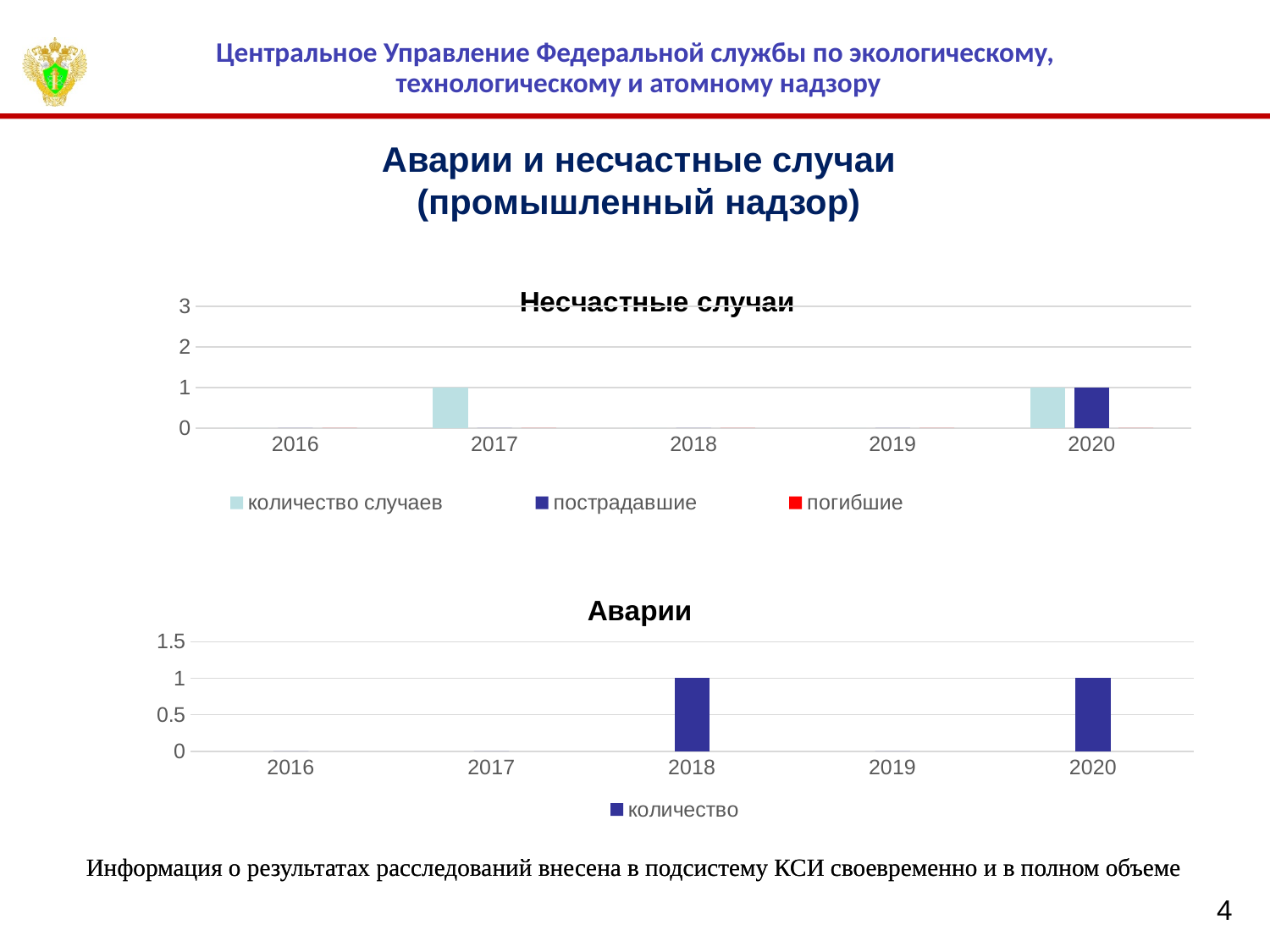
In the 'Аварии' chart, what is the name of the series in the legend? количество In the 'Несчастные случаи' chart, which series is shown in red in the legend? погибшие In the 'Несчастные случаи' chart, what is the value of 'пострадавшие' for 2020? 1 In the 'Аварии' chart, what kind of chart is it? bar chart In the 'Несчастные случаи' chart, is the value of 'количество случаев' for 2020 greater or less than 2? less In the 'Аварии' chart, is the value for 2018 greater or less than 0.5? greater In the 'Аварии' chart, what is the value for 2018? 1 In the 'Несчастные случаи' chart, how many series does the legend list? 3 In the 'Аварии' chart, how many series does the legend list? 1 In the 'Несчастные случаи' chart, how many years are shown on the x axis? 5 In the 'Аварии' chart, what is the value for 2020? 1 In the 'Несчастные случаи' chart, what is the value of 'количество случаев' for 2017? 1